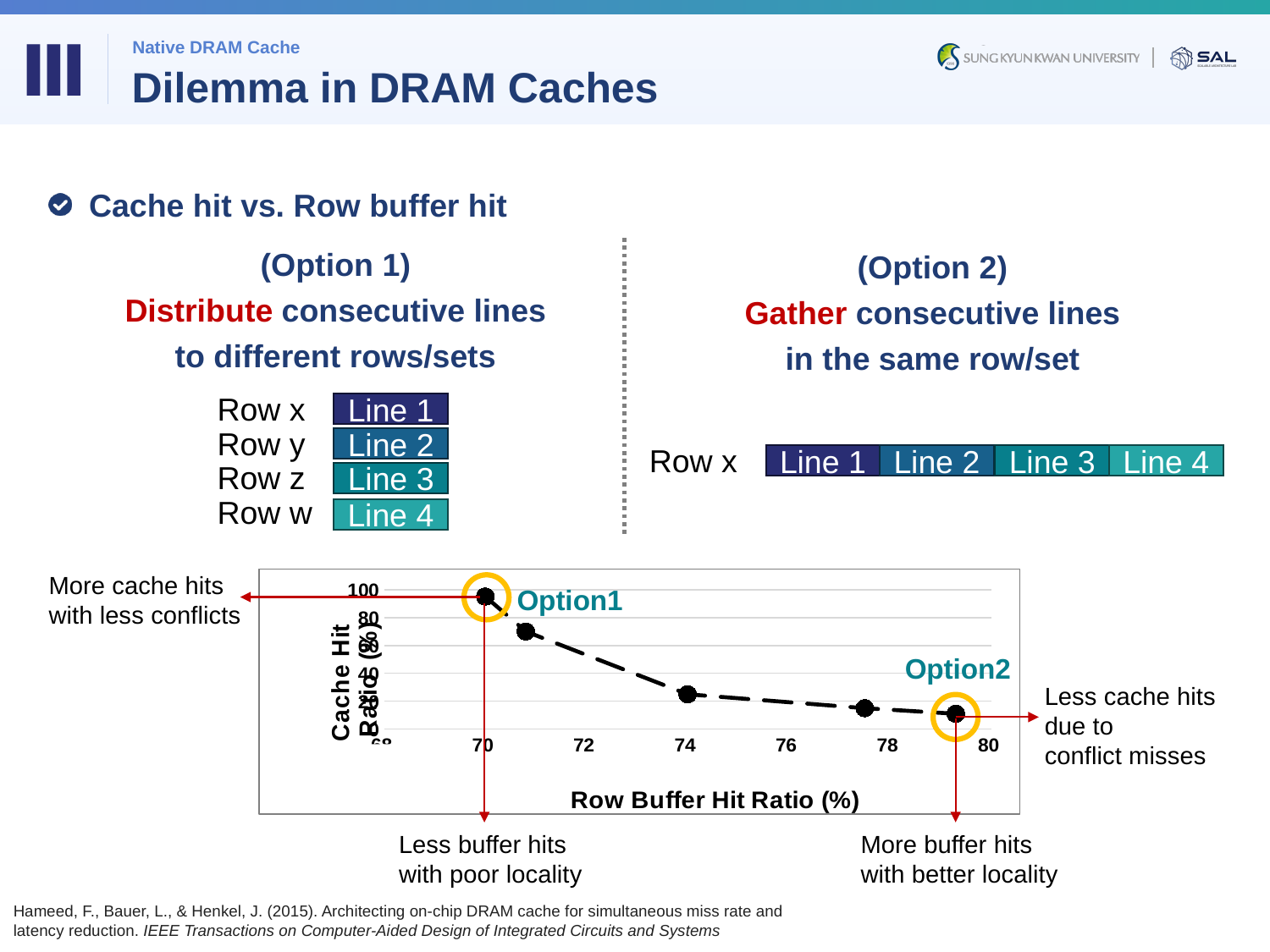
Is the cache hit ratio for Option2 greater or less than 40? less What kind of chart is shown on the slide? Line chart Is the row buffer hit ratio for Option1 greater or less than 72? less Is the row buffer hit ratio for Option2 greater or less than 78? greater Which labelled point has the highest cache hit ratio, Option1 or Option2? Option1 Which labelled point has the larger row buffer hit ratio, Option1 or Option2? Option2 How many data points are plotted on the chart? 5 What is the title of the x axis of the chart? Row Buffer Hit Ratio (%) Which labelled point has the lowest cache hit ratio? Option2 What is the title of the y axis of the chart? Cache Hit Ratio (%) Do the cache hit ratio values rise or fall as the row buffer hit ratio increases along the x axis? Fall